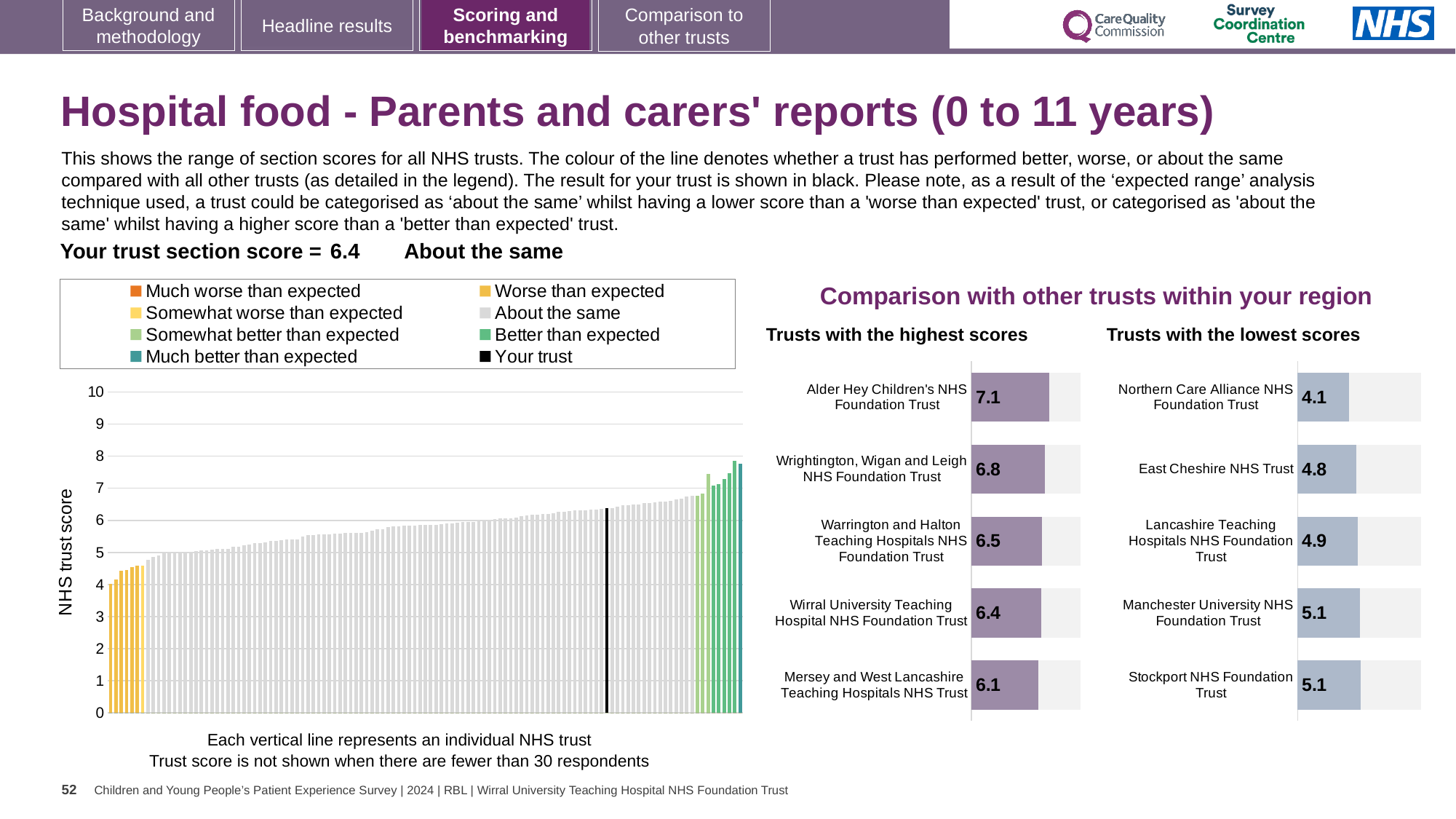
In the 'Trusts with the highest scores' chart, what is the score for Wirral University Teaching Hospital NHS Foundation Trust? 6.4 In the large 'NHS trust score' chart on the left, do the values rise or fall from left to right along the x axis? Rise In the 'Trusts with the lowest scores' chart, which has the larger score: Lancashire Teaching Hospitals NHS Foundation Trust or Northern Care Alliance NHS Foundation Trust? Lancashire Teaching Hospitals NHS Foundation Trust In the 'Trusts with the highest scores' chart, what is the difference between the scores of Alder Hey Children's NHS Foundation Trust and Mersey and West Lancashire Teaching Hospitals NHS Trust? 1.0 In the 'Trusts with the lowest scores' chart, what is the score for East Cheshire NHS Trust? 4.8 What kind of chart is the large chart on the left with the 'NHS trust score' axis? Bar chart In the 'Trusts with the lowest scores' chart, which trust has the lowest score? Northern Care Alliance NHS Foundation Trust In the 'Trusts with the highest scores' chart, which trust has the highest score? Alder Hey Children's NHS Foundation Trust How many entries does the legend above the large 'NHS trust score' chart list? 8 In the large 'NHS trust score' chart on the left, is the value of the black bar (your trust) greater or less than 6? greater In the 'Trusts with the highest scores' chart, what is the score for Alder Hey Children's NHS Foundation Trust? 7.1 How many trusts are shown in the 'Trusts with the lowest scores' chart? 5